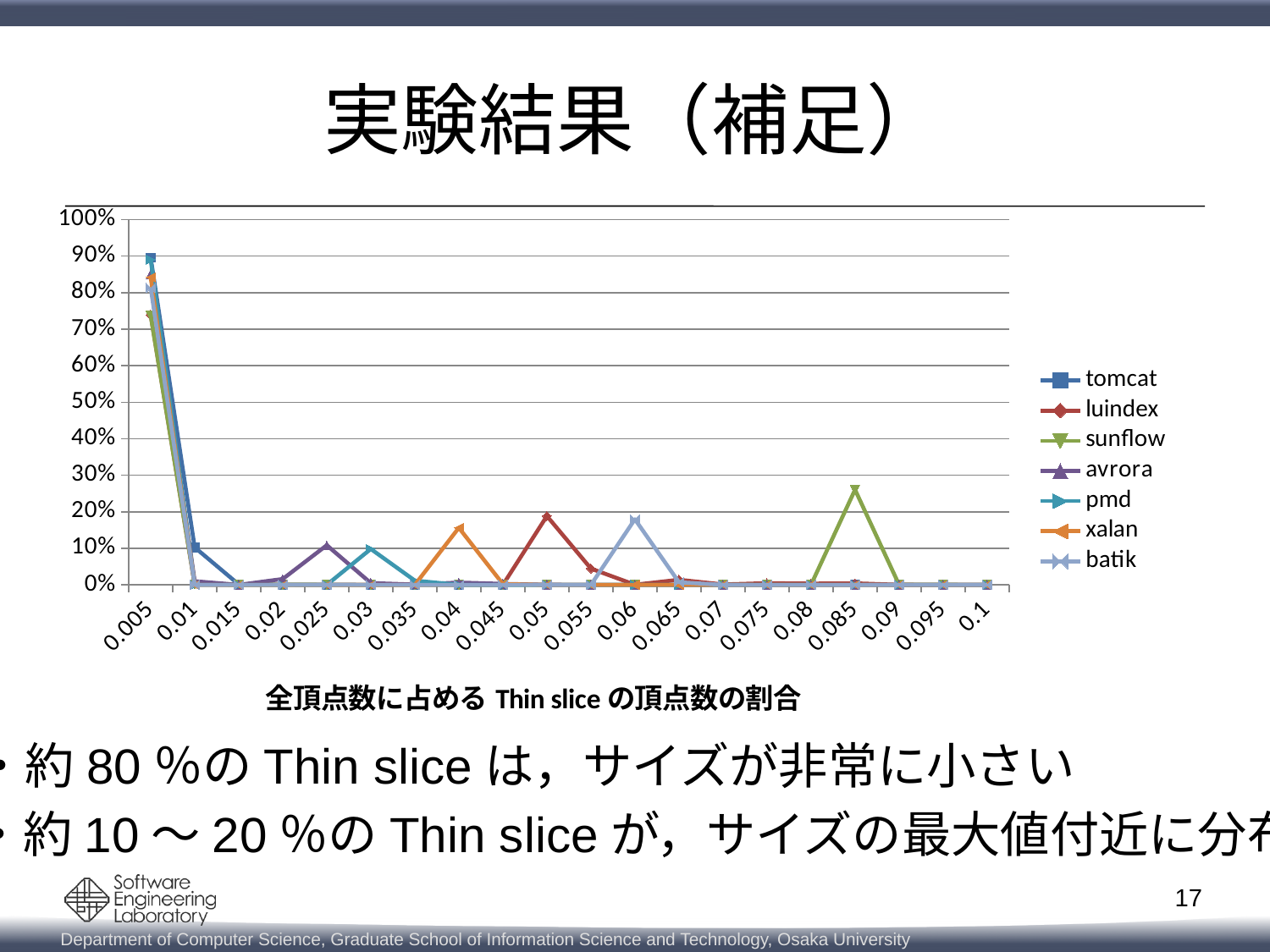
How many categories are shown along the x axis? 20 Which series is listed first in the legend? tomcat Is the value for tomcat at 0.005 greater or less than 80%? greater Is the value for sunflow at 0.085 greater or less than 20%? greater Which is larger: the value for sunflow at 0.085 or the value for xalan at 0.04? sunflow at 0.085 Is the value for avrora at 0.025 greater or less than 20%? less What kind of chart is shown on the slide? line chart How many series does the legend list? 7 Does the tomcat series rise or fall from 0.005 to 0.01? fall